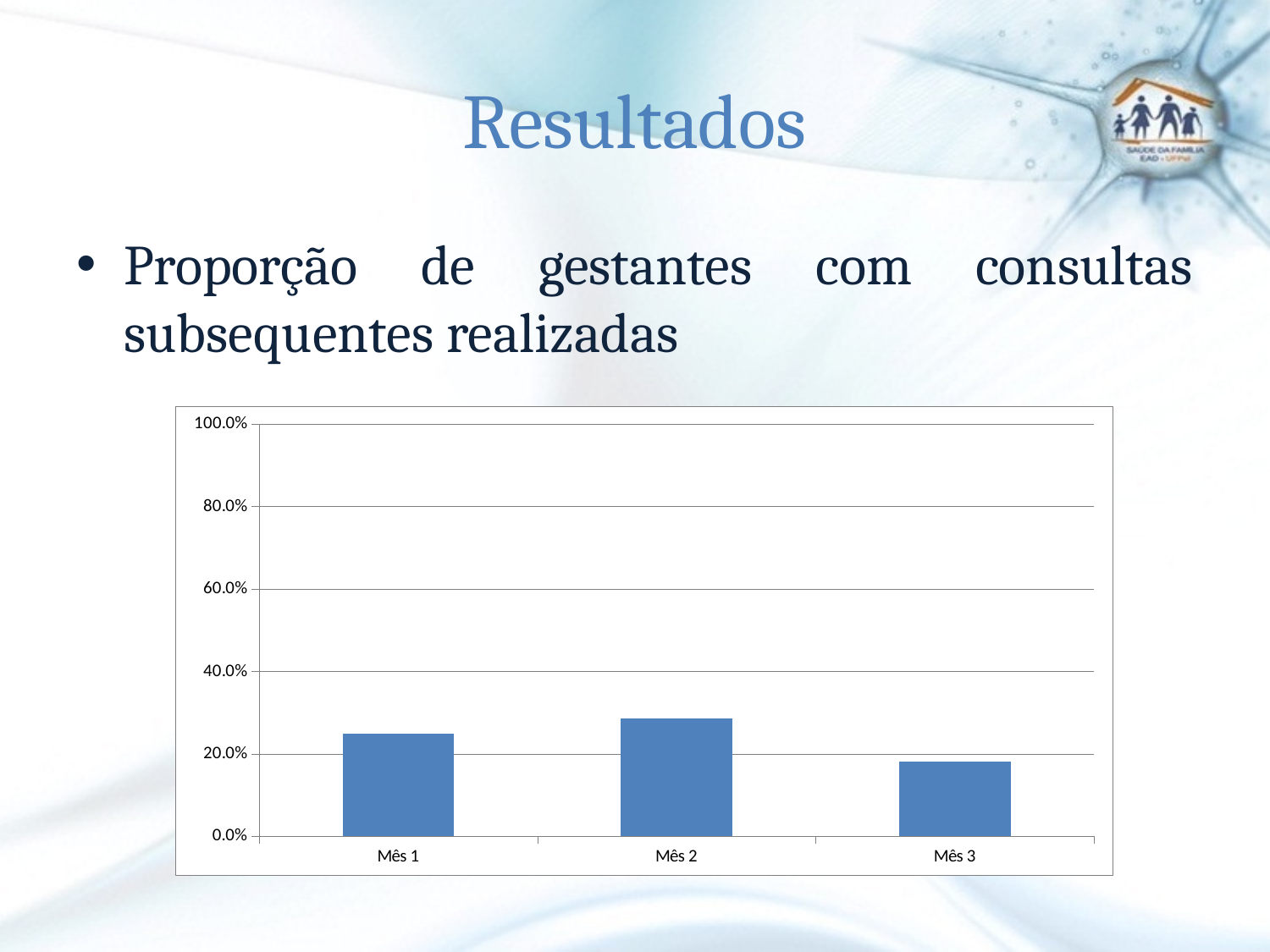
What kind of chart is shown on the slide? bar chart Is the value for Mês 2 greater or less than 40.0%? less Is the value for Mês 2 greater or less than 20.0%? greater Which month has the highest bar in the chart? Mês 2 What is the highest value shown on the chart's y axis? 100.0% Is the value for Mês 3 greater or less than 20.0%? less How many categories (months) are shown on the x axis of the chart? 3 Does the value rise or fall from Mês 2 to Mês 3? fall Which month has the lowest bar in the chart? Mês 3 Which is larger, the value for Mês 1 or the value for Mês 3? Mês 1 Which is larger, the value for Mês 2 or the value for Mês 1? Mês 2